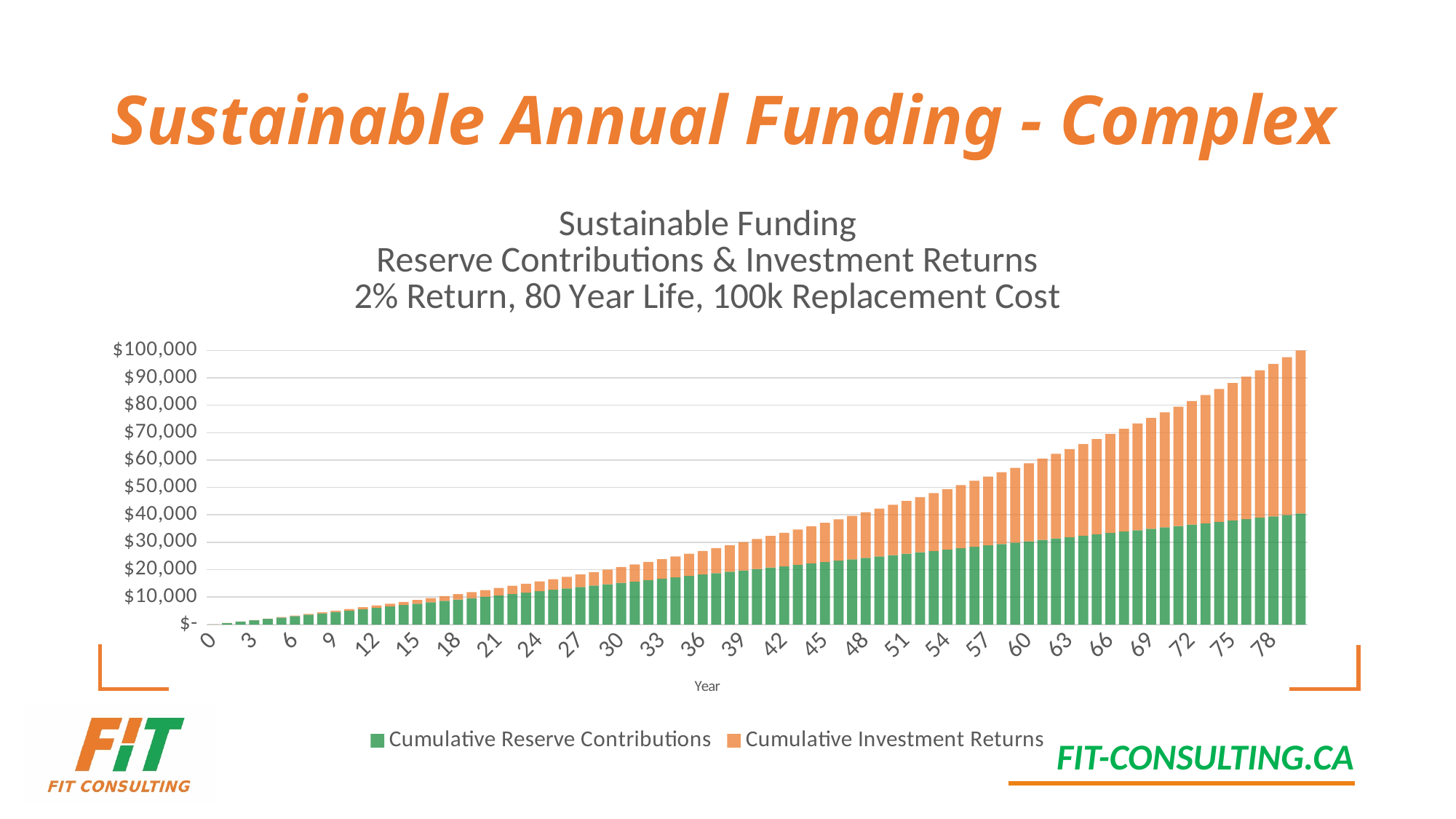
At year 78, which series is larger: Cumulative Reserve Contributions or Cumulative Investment Returns? Cumulative Investment Returns Is the total value of the bar at year 45 greater or less than $40,000? less Is the total value of the bar at year 78 greater or less than $90,000? greater What is the title of the x axis? Year Do the total bar heights rise or fall as the year increases along the x axis? Rise Is the Cumulative Reserve Contributions value at year 30 greater or less than $10,000? greater How many series does the legend list? 2 What kind of chart is shown on the slide? Stacked bar chart Which series is shown in orange in the legend? Cumulative Investment Returns Which has the larger total bar: year 0 or year 78? Year 78